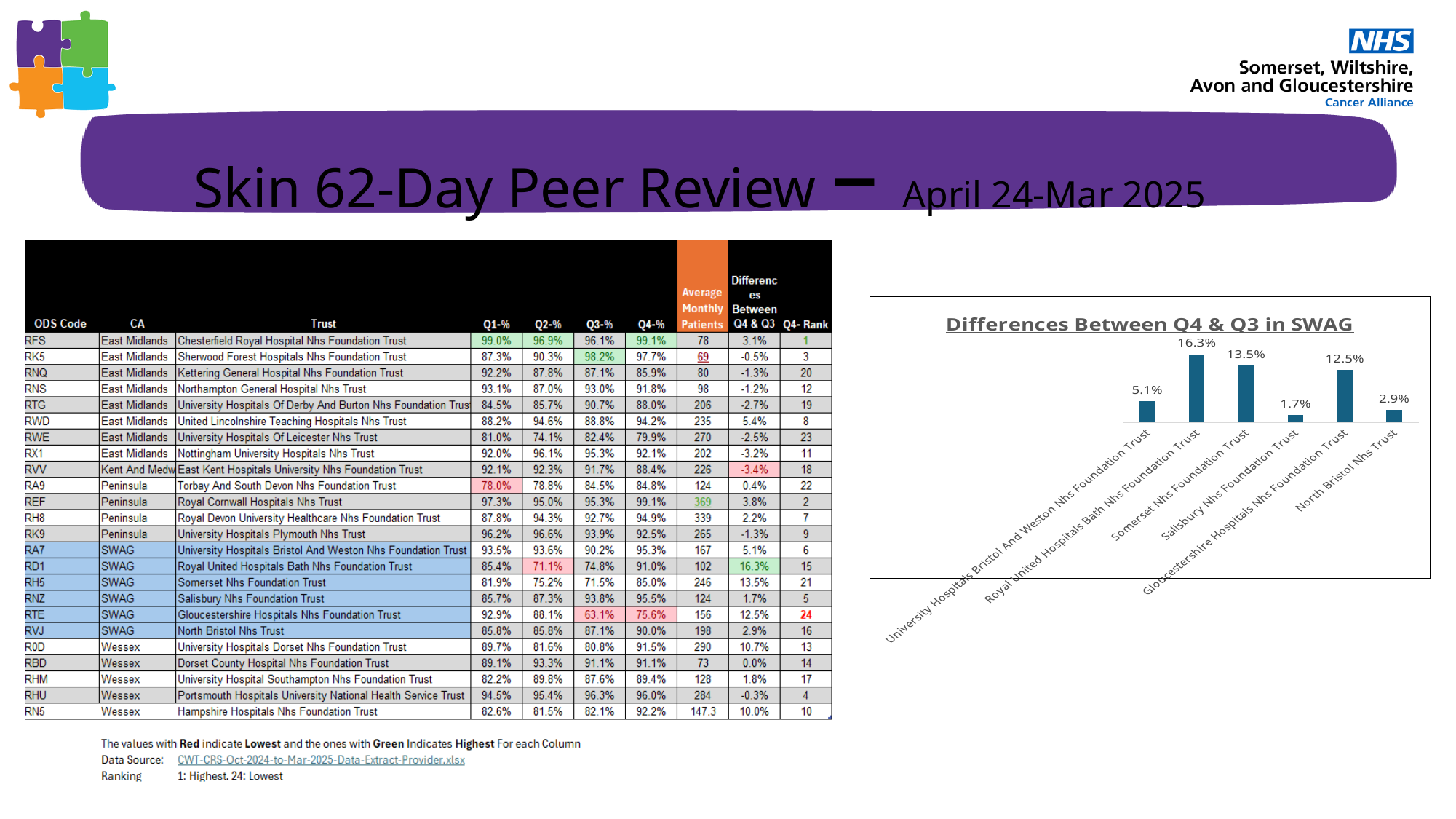
Which trust has the lowest value in the chart? Salisbury Nhs Foundation Trust What is the value for North Bristol Nhs Trust in the chart? 2.9% What is the difference between the values for Somerset Nhs Foundation Trust and University Hospitals Bristol And Weston Nhs Foundation Trust? 8.4% What is the value for Gloucestershire Hospitals Nhs Foundation Trust in the chart? 12.5% Which is larger: the value for Somerset Nhs Foundation Trust or the value for Gloucestershire Hospitals Nhs Foundation Trust? Somerset Nhs Foundation Trust What kind of chart is shown on the slide? Bar chart What is the title of the chart? Differences Between Q4 & Q3 in SWAG What is the difference between the values for Royal United Hospitals Bath Nhs Foundation Trust and North Bristol Nhs Trust? 13.4% What is the value for Royal United Hospitals Bath Nhs Foundation Trust in the chart? 16.3% How many trusts are shown in the chart? 6 What is the value for Salisbury Nhs Foundation Trust in the chart? 1.7% Which trust has the highest value in the chart? Royal United Hospitals Bath Nhs Foundation Trust